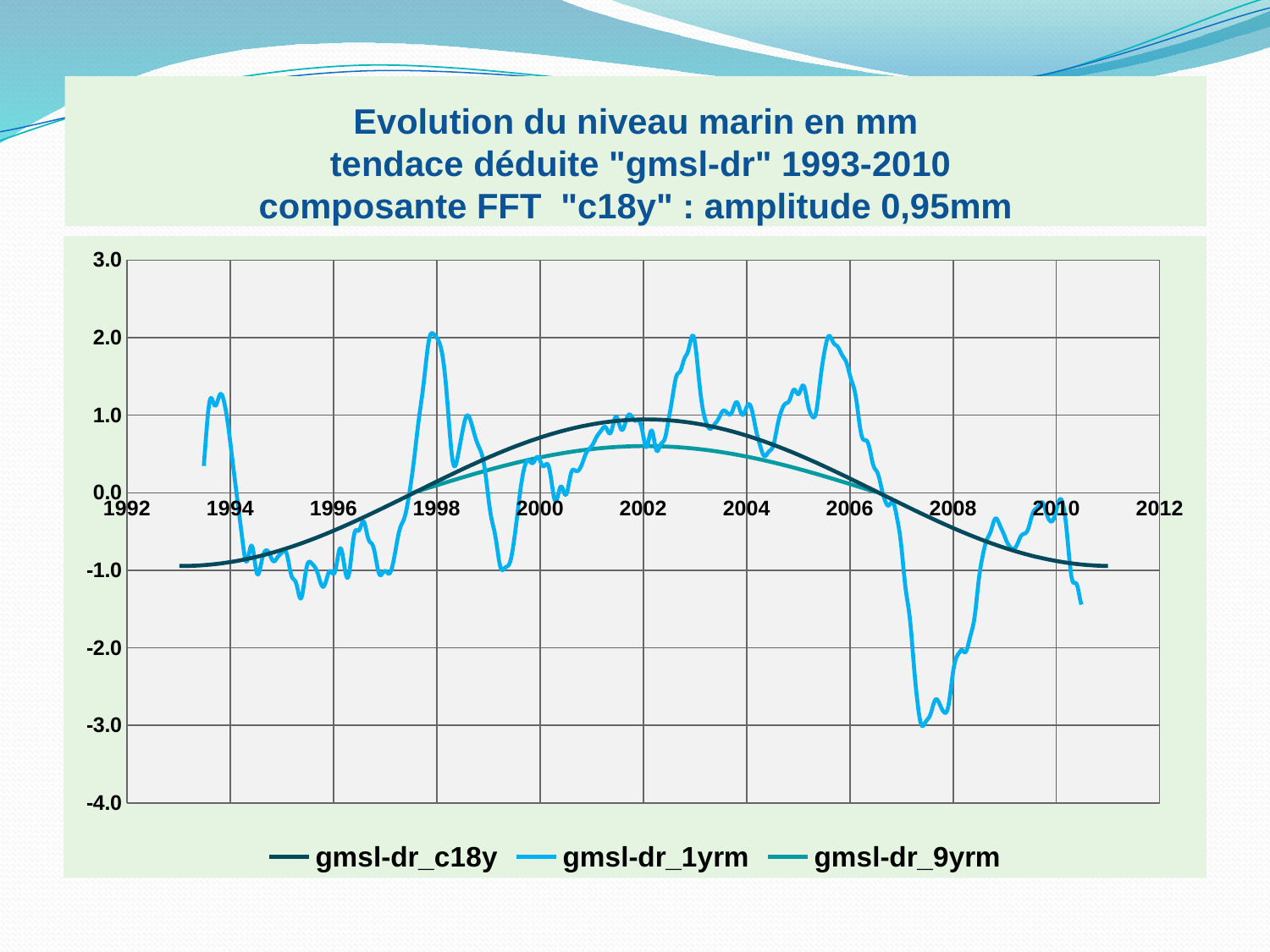
Is the peak of gmsl-dr_1yrm near 1998 greater or less than 1.0? greater What kind of chart is shown on the slide? line chart Does gmsl-dr_c18y rise or fall between 1993 and 2002? rise Is the peak value of gmsl-dr_9yrm around 2002 greater or less than 1.0? less At 2002, which series is higher: gmsl-dr_c18y or gmsl-dr_9yrm? gmsl-dr_c18y What are the names of the series listed in the legend? gmsl-dr_c18y, gmsl-dr_1yrm, gmsl-dr_9yrm Is the lowest value reached by gmsl-dr_1yrm around 2008 greater or less than -2.0? less Does gmsl-dr_c18y rise or fall between 2002 and 2010? fall How many series does the legend list? 3 What amplitude is stated in the chart title for the FFT component "c18y"? 0,95mm